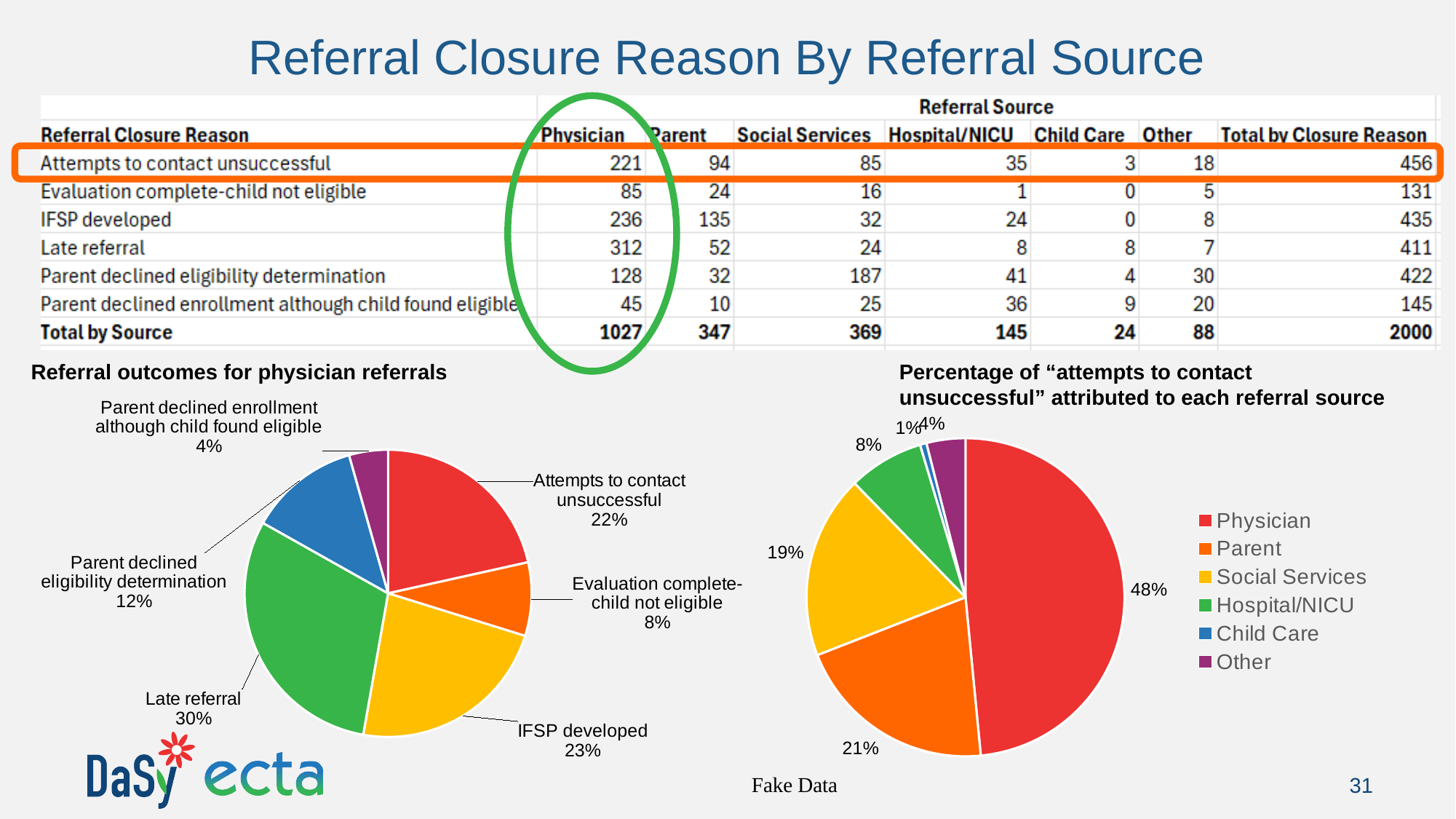
In the 'Percentage of attempts to contact unsuccessful attributed to each referral source' chart, what percentage is attributed to Social Services? 19% In the 'Percentage of attempts to contact unsuccessful attributed to each referral source' chart, how many referral sources does the legend list? 6 In the 'Percentage of attempts to contact unsuccessful attributed to each referral source' chart, which is larger, Parent or Hospital/NICU? Parent In the 'Referral outcomes for physician referrals' chart, how many slices does the pie have? 6 In the 'Percentage of attempts to contact unsuccessful attributed to each referral source' chart, what percentage is attributed to Physician? 48% What type of chart is used for 'Referral outcomes for physician referrals'? Pie chart In the 'Referral outcomes for physician referrals' chart, which outcome has the largest slice? Late referral In the 'Percentage of attempts to contact unsuccessful attributed to each referral source' chart, which referral source has the smallest share? Child Care In the 'Referral outcomes for physician referrals' chart, what percentage is labelled for Late referral? 30% In the 'Referral outcomes for physician referrals' chart, which outcome has the smallest slice? Parent declined enrollment although child found eligible In the 'Referral outcomes for physician referrals' chart, what is the difference in percentage points between Late referral and Attempts to contact unsuccessful? 8 In the 'Referral outcomes for physician referrals' chart, what percentage is labelled for IFSP developed? 23%